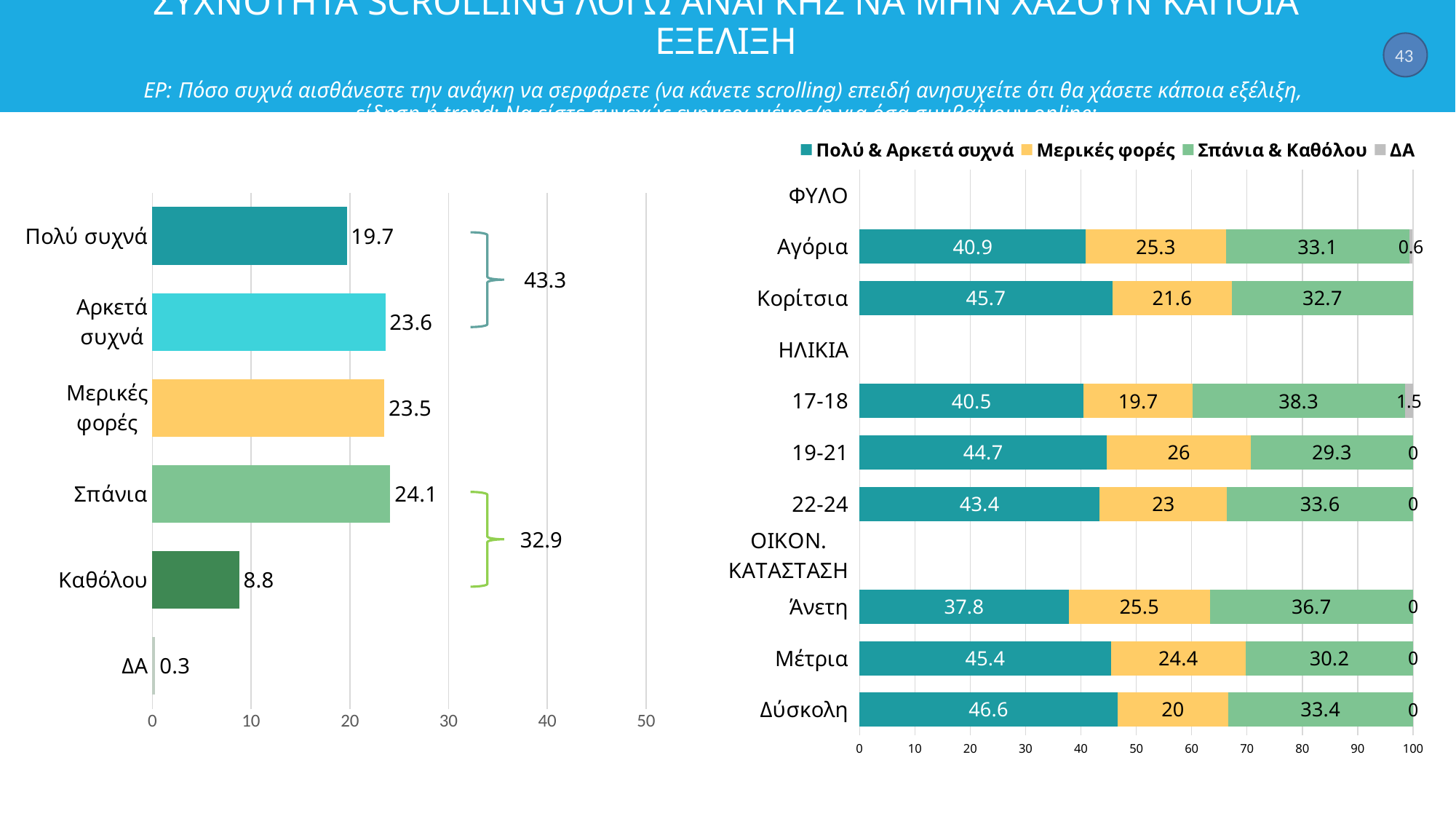
In the right chart, what is the Πολύ & Αρκετά συχνά value for Κορίτσια? 45.7 In the left chart, which category has the lowest value? ΔΑ In the left chart, what is the value for Σπάνια? 24.1 In the left chart, what is the value for Καθόλου? 8.8 In the left chart, is the value for Πολύ συχνά greater or less than 20? less In the right chart, how many series does the legend list? 4 In the right chart, what is the Σπάνια & Καθόλου value for 17-18? 38.3 What kind of chart is the right chart? stacked bar chart In the right chart, which is larger: the Πολύ & Αρκετά συχνά value for Άνετη or for Δύσκολη? Δύσκολη In the right chart, what is the difference between the Μερικές φορές values for Αγόρια and Κορίτσια? 3.7 In the left chart, how many categories are shown? 6 In the left chart, what is the difference between the values for Αρκετά συχνά and Πολύ συχνά? 3.9